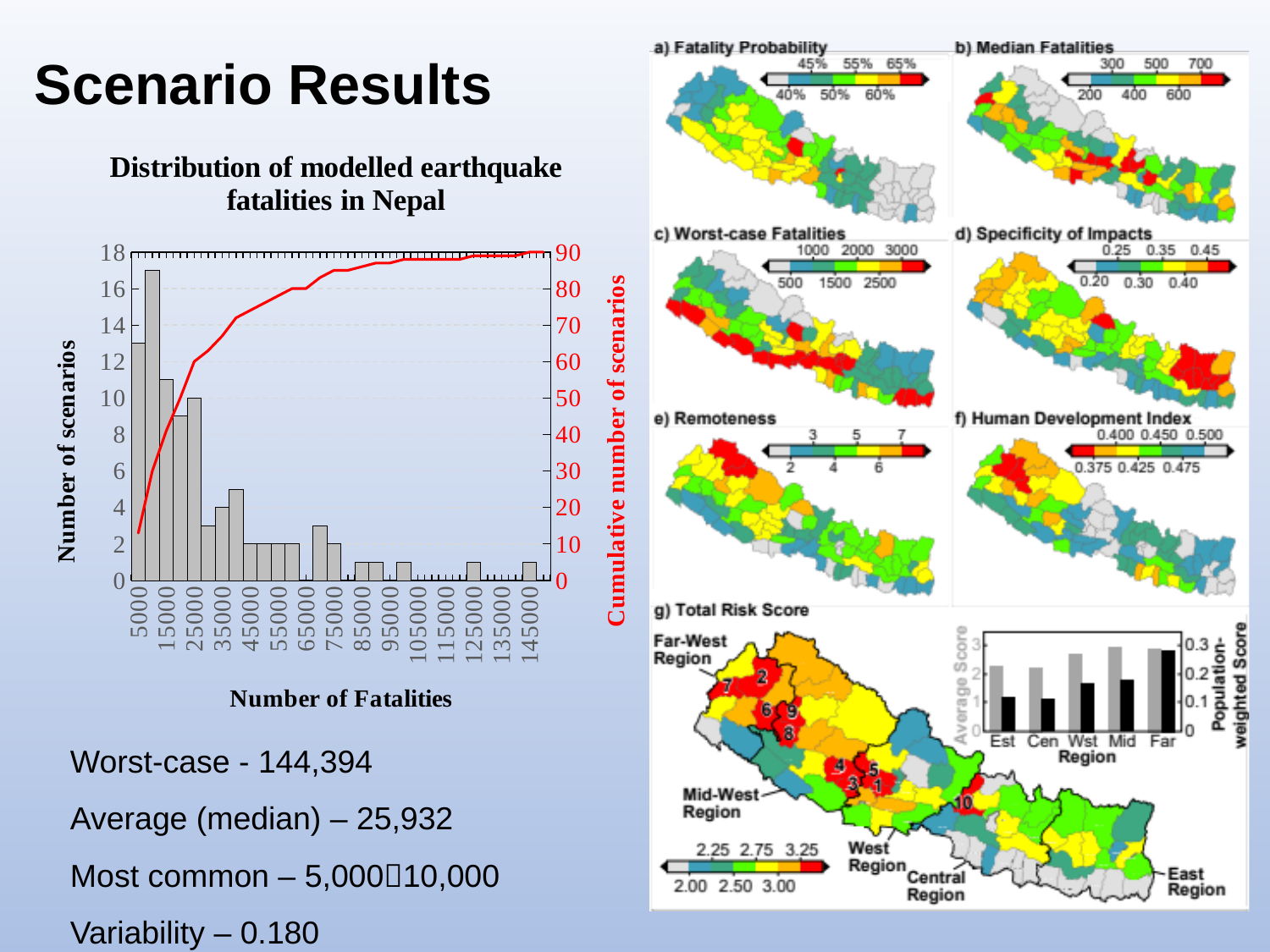
In the small bar chart inside panel g) Total Risk Score, how many regions are shown on the x axis? 5 On the 'Distribution of modelled earthquake fatalities in Nepal' chart, is the tallest bar greater or less than 16 scenarios? greater On the 'Distribution of modelled earthquake fatalities in Nepal' chart, what is the highest tick value on the left y axis? 18 On the 'Distribution of modelled earthquake fatalities in Nepal' chart, what is the highest tick value on the right y axis? 90 What is the title of the chart on the left of the slide? Distribution of modelled earthquake fatalities in Nepal What kind of chart is the 'Distribution of modelled earthquake fatalities in Nepal' chart? bar chart with a line On the 'Distribution of modelled earthquake fatalities in Nepal' chart, is the final value of the red cumulative line greater or less than 80? greater On the 'Distribution of modelled earthquake fatalities in Nepal' chart, what is the label of the right-hand (red) y axis? Cumulative number of scenarios In the small bar chart inside panel g) Total Risk Score, which region has the tallest black bar? Far According to the text below the left chart, what is the worst-case number of fatalities? 144,394 According to the text below the left chart, what is the average (median) number of fatalities? 25,932 On the 'Distribution of modelled earthquake fatalities in Nepal' chart, does the red cumulative line rise or fall as the number of fatalities increases? rises